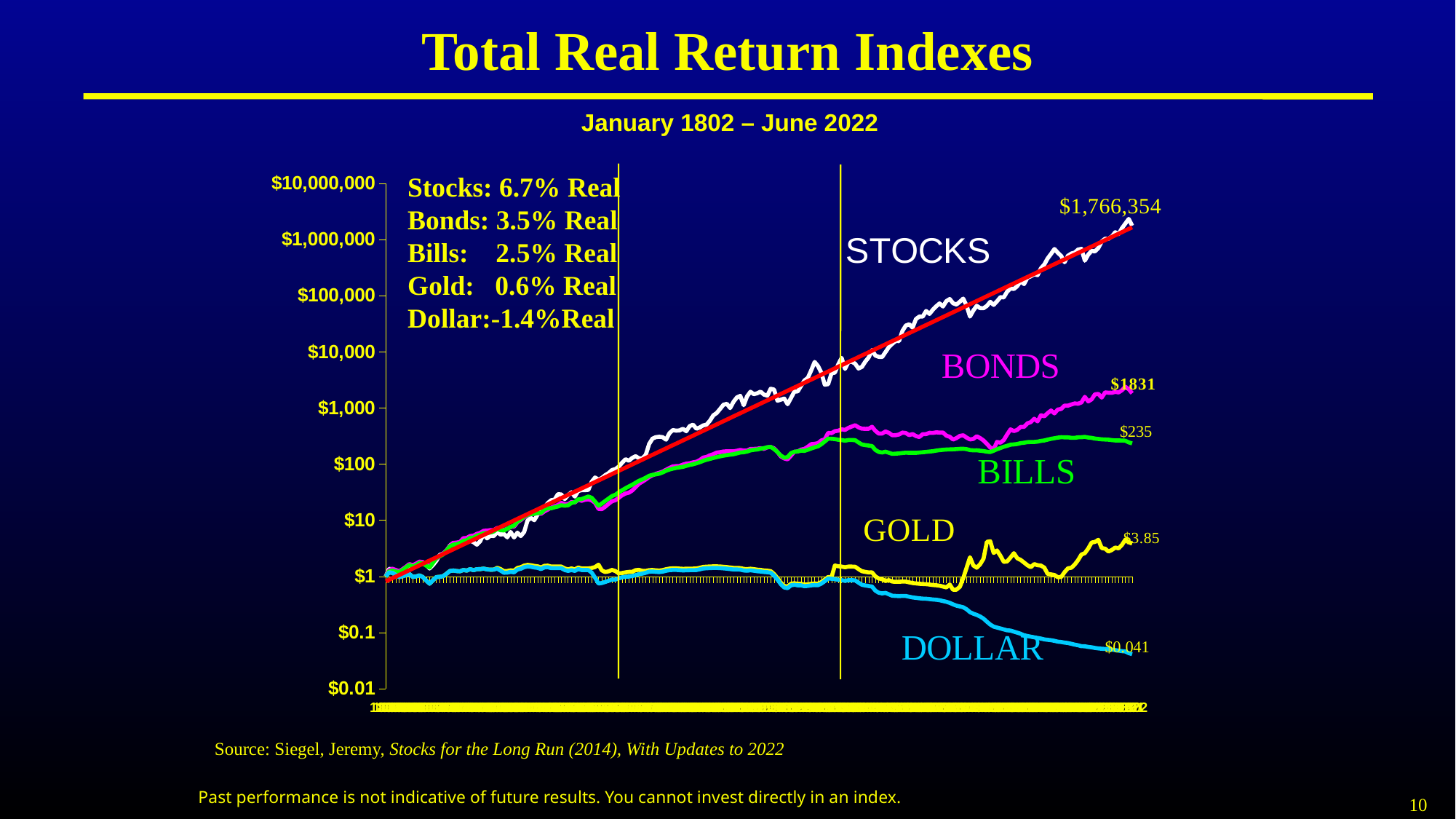
What is the ending value shown for Gold? $3.85 Which has a larger ending value, Bonds or Bills? Bonds Which series has the lowest ending value? Dollar What is the ending value shown for Stocks? $1,766,354 Does the Dollar line rise or fall over the period shown? fall What is the ending value shown for the Dollar? $0.041 What kind of chart is shown on the slide? line chart Which series has the highest ending value? Stocks What is the title of the chart on the slide? Total Real Return Indexes What is the ending value shown for Bonds? $1831 What is the ending value shown for Bills? $235 What annual real return is listed for Gold? 0.6% Real